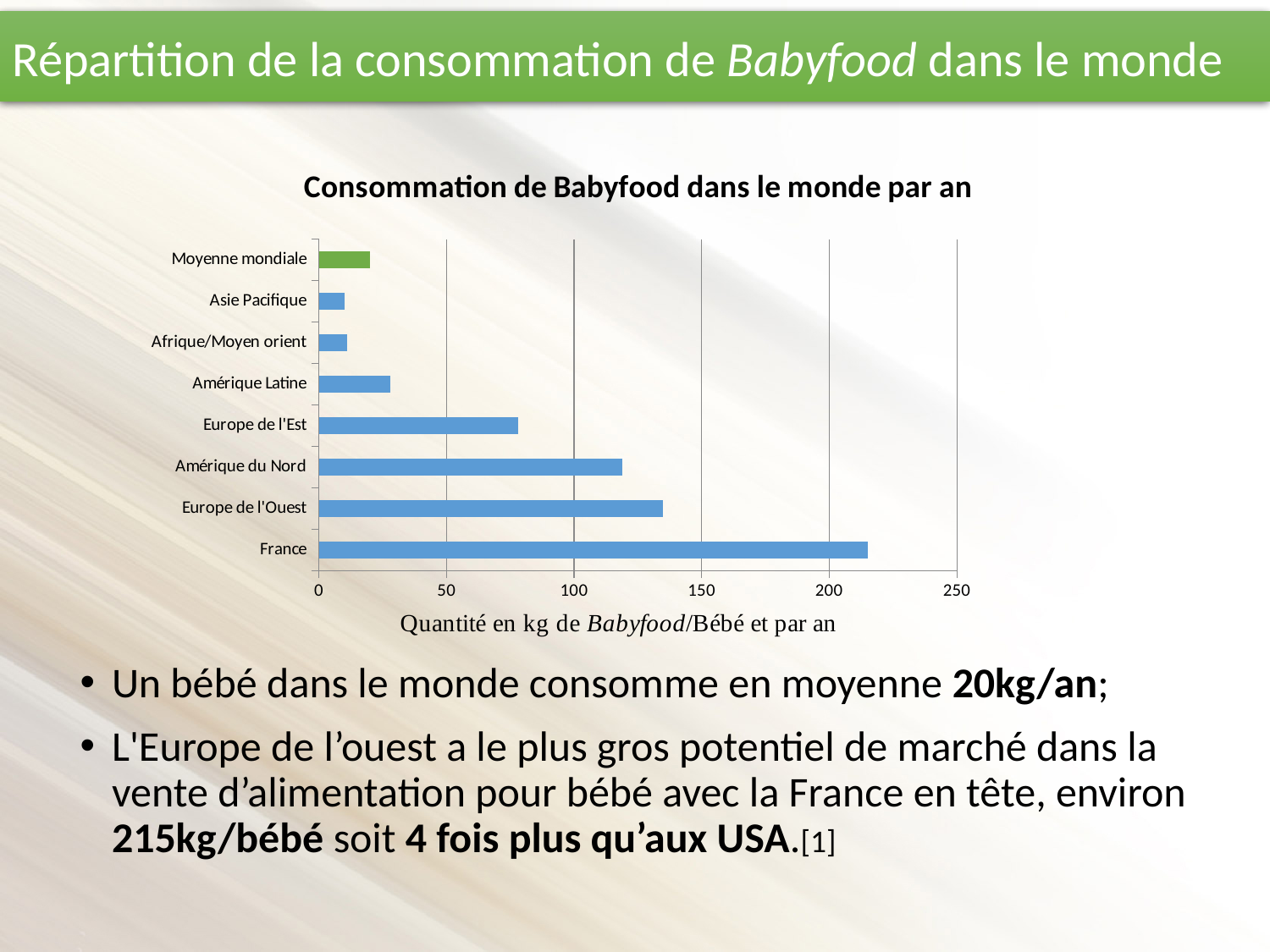
Which has a larger value, Europe de l'Est or Amérique Latine? Europe de l'Est Which has a larger value, Europe de l'Ouest or Amérique du Nord? Europe de l'Ouest Is the value for France greater or less than 200? greater Is the value for Amérique du Nord greater or less than 100? greater Which category's bar is shown in green rather than blue? Moyenne mondiale Is the value for Europe de l'Est greater or less than 100? less What is the title of the chart? Consommation de Babyfood dans le monde par an How many categories are plotted in the chart? 8 What kind of chart is shown on the slide? Bar chart Which category has the highest value in the chart? France